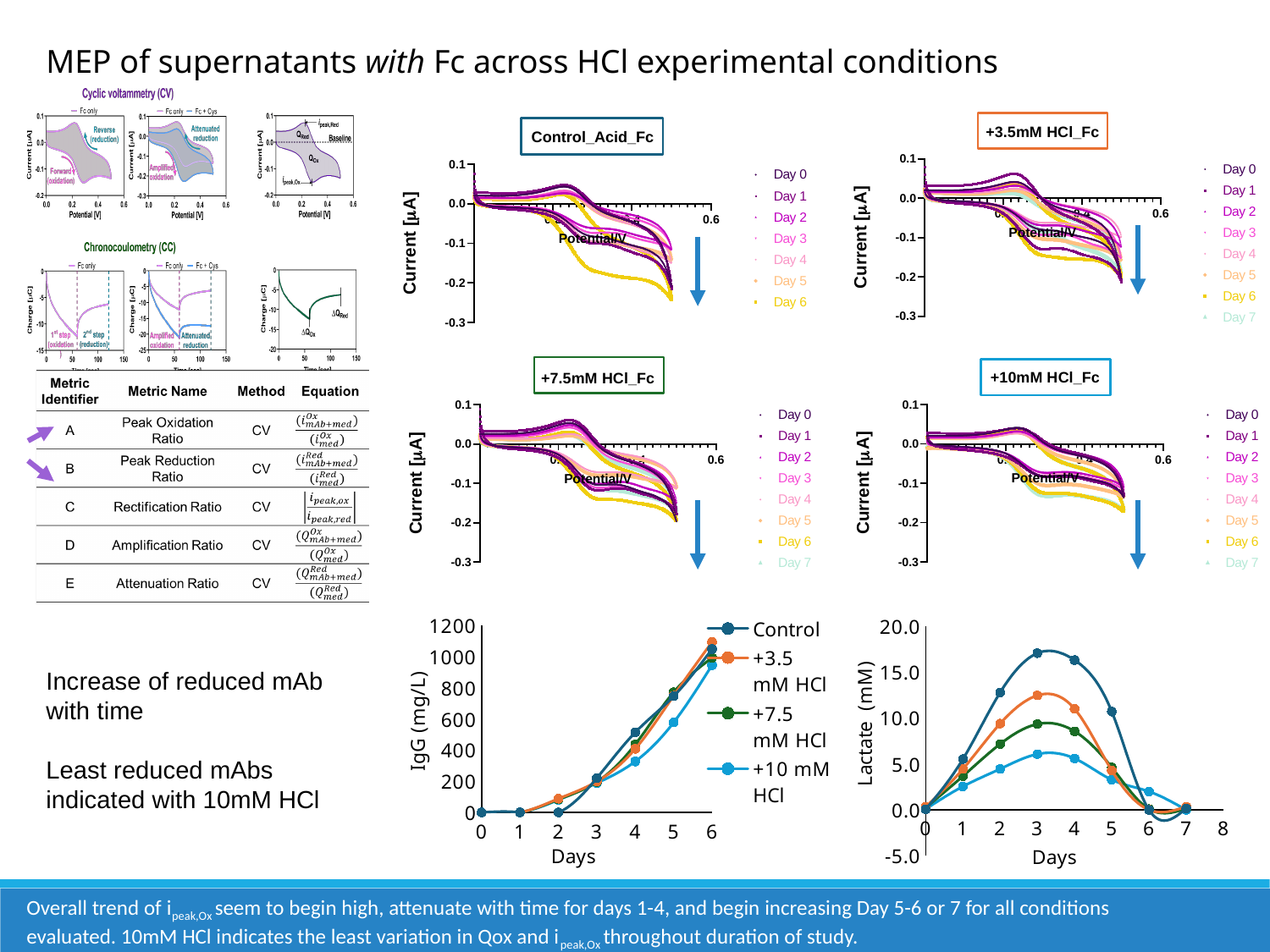
In the IgG (mg/L) chart, is the value for +10 mM HCl at Day 4 greater or less than 400? less In the IgG (mg/L) chart at the bottom, how many series does the legend list? 4 How many entries does the legend of the Control_Acid_Fc chart list? 7 In the Lactate (mM) chart, which series has the lowest value at Day 3? +10 mM HCl What is the y-axis label of the +7.5mM HCl_Fc chart? Current [µA] In the Lactate (mM) chart, is the value for Control at Day 3 greater or less than 15.0? greater In the IgG (mg/L) chart, is the value for Control at Day 5 greater or less than 600? greater In the Lactate (mM) chart, which series reaches the highest peak value? Control How many entries does the legend of the +10mM HCl_Fc chart list? 8 In the IgG (mg/L) chart, do the values for the Control series rise or fall from Day 0 to Day 6? rise What kind of chart is the IgG (mg/L) versus Days chart? line chart In the Lactate (mM) chart, which is larger at Day 3: the value for +3.5 mM HCl or the value for +7.5 mM HCl? +3.5 mM HCl